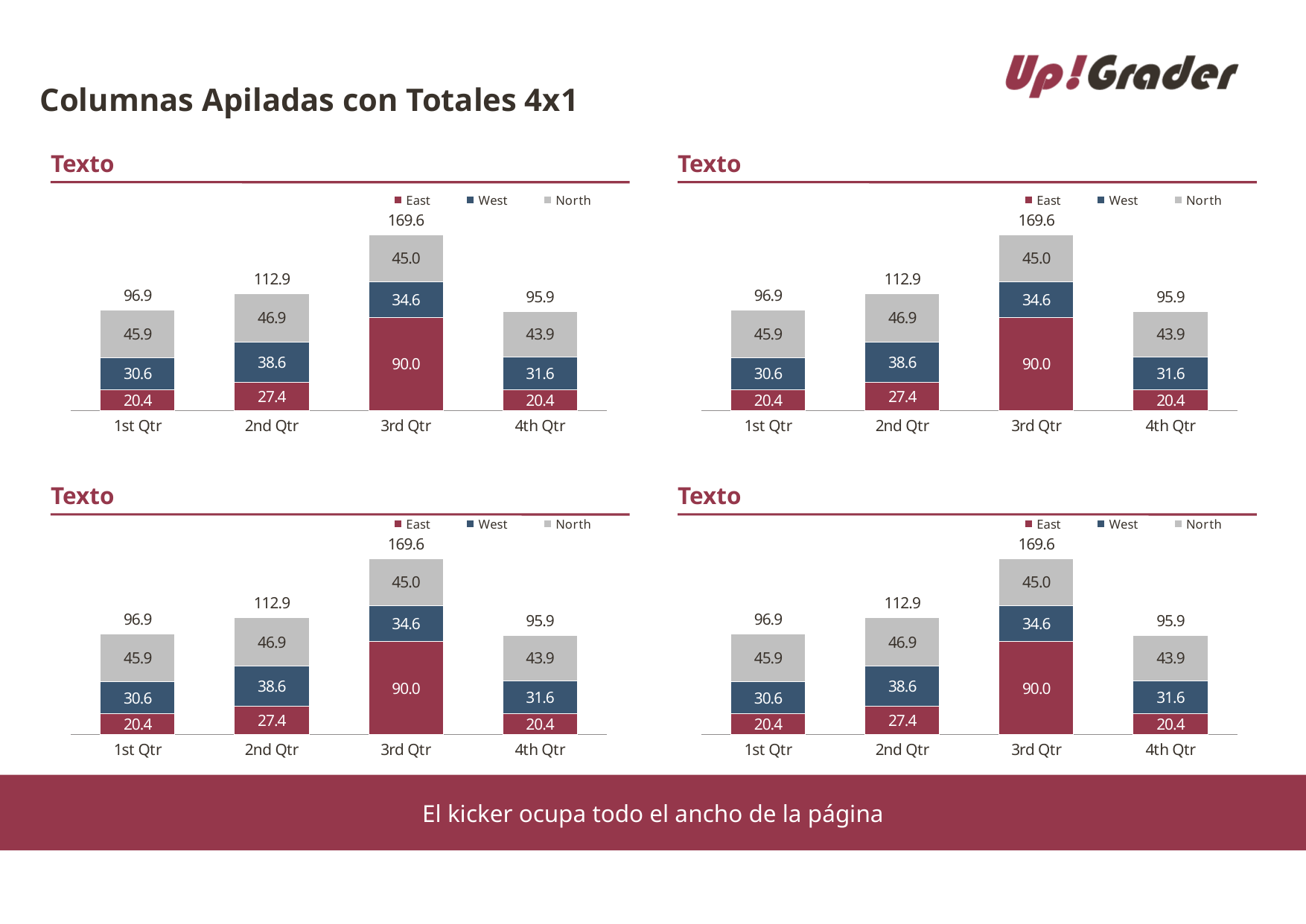
In the top-left chart, what is the East value for 3rd Qtr? 90.0 In the top-left chart, which quarter has the highest stacked total? 3rd Qtr How many categories are shown on the x axis of the top-left chart? 4 In the bottom-left chart, what is the difference between the 3rd Qtr total and the 1st Qtr total? 72.7 How many series does the legend of the top-right chart list? 3 In the top-right chart, what is the West value for 2nd Qtr? 38.6 In the bottom-left chart, what is the North value for 4th Qtr? 43.9 In the top-right chart, which quarter has the lowest stacked total? 4th Qtr What kind of chart is the bottom-left chart? Stacked bar chart In the bottom-right chart, which series is shown in grey according to the legend? North In the bottom-right chart, which is larger: the West value for 1st Qtr or the West value for 4th Qtr? 4th Qtr In the bottom-right chart, what is the total shown above the 2nd Qtr bar? 112.9